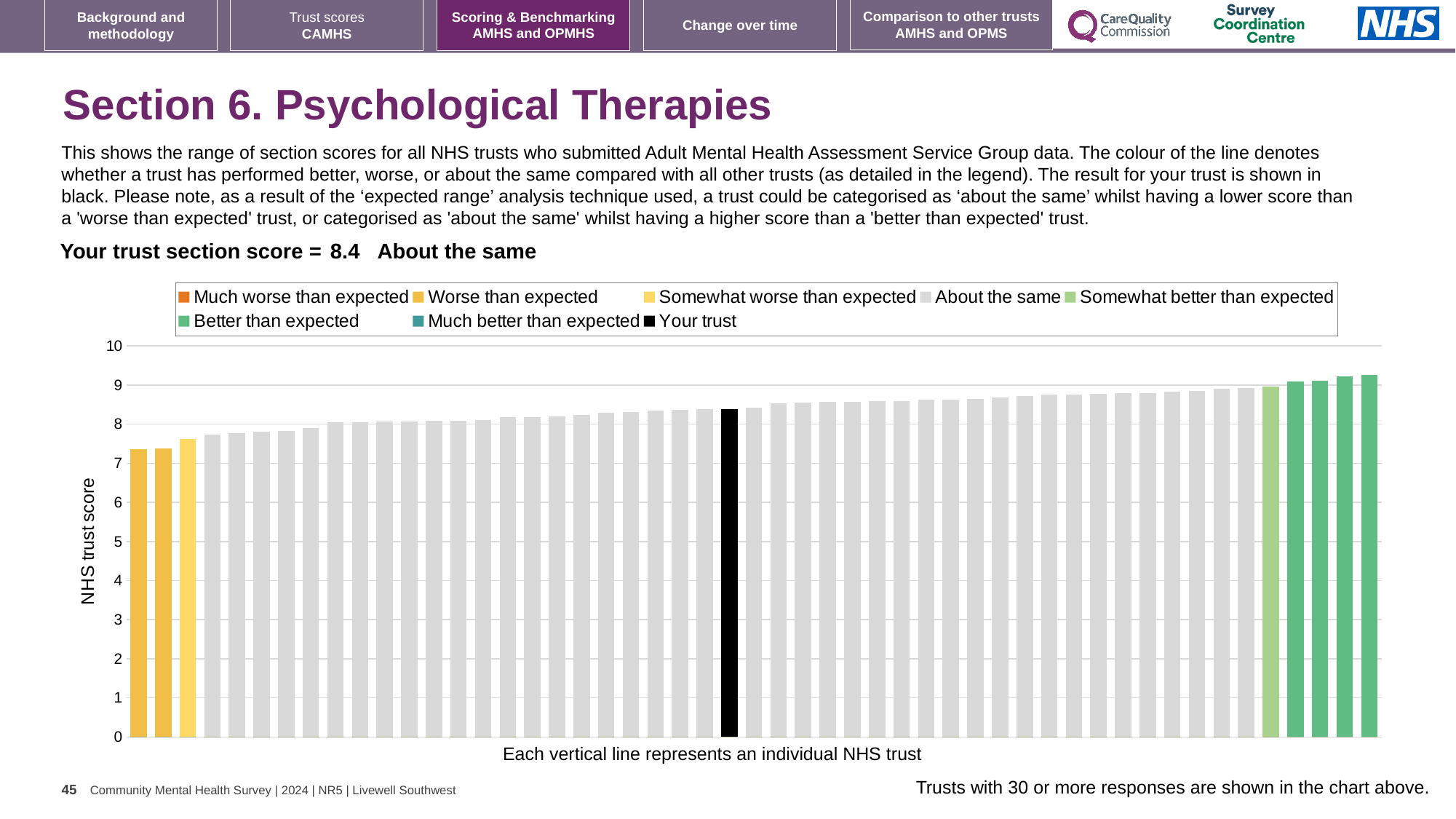
Which legend category does the tallest bar in the chart belong to? Better than expected Is the value for 'Your trust' greater or less than 8? greater Which legend category does the shortest bar in the chart belong to? Worse than expected What is the label on the vertical axis of the chart? NHS trust score Is the value of the tallest bar greater or less than 9? greater Do the bar values rise or fall from left to right along the x axis? Rise How many bars are coloured as 'Worse than expected'? 2 What kind of chart is shown on the slide? Bar chart Which performance category is 'Your trust' placed in for this section? About the same Is the value of the shortest bar greater or less than 8? less How many entries does the chart legend list? 8 What is the section score for 'Your trust' shown on the slide? 8.4